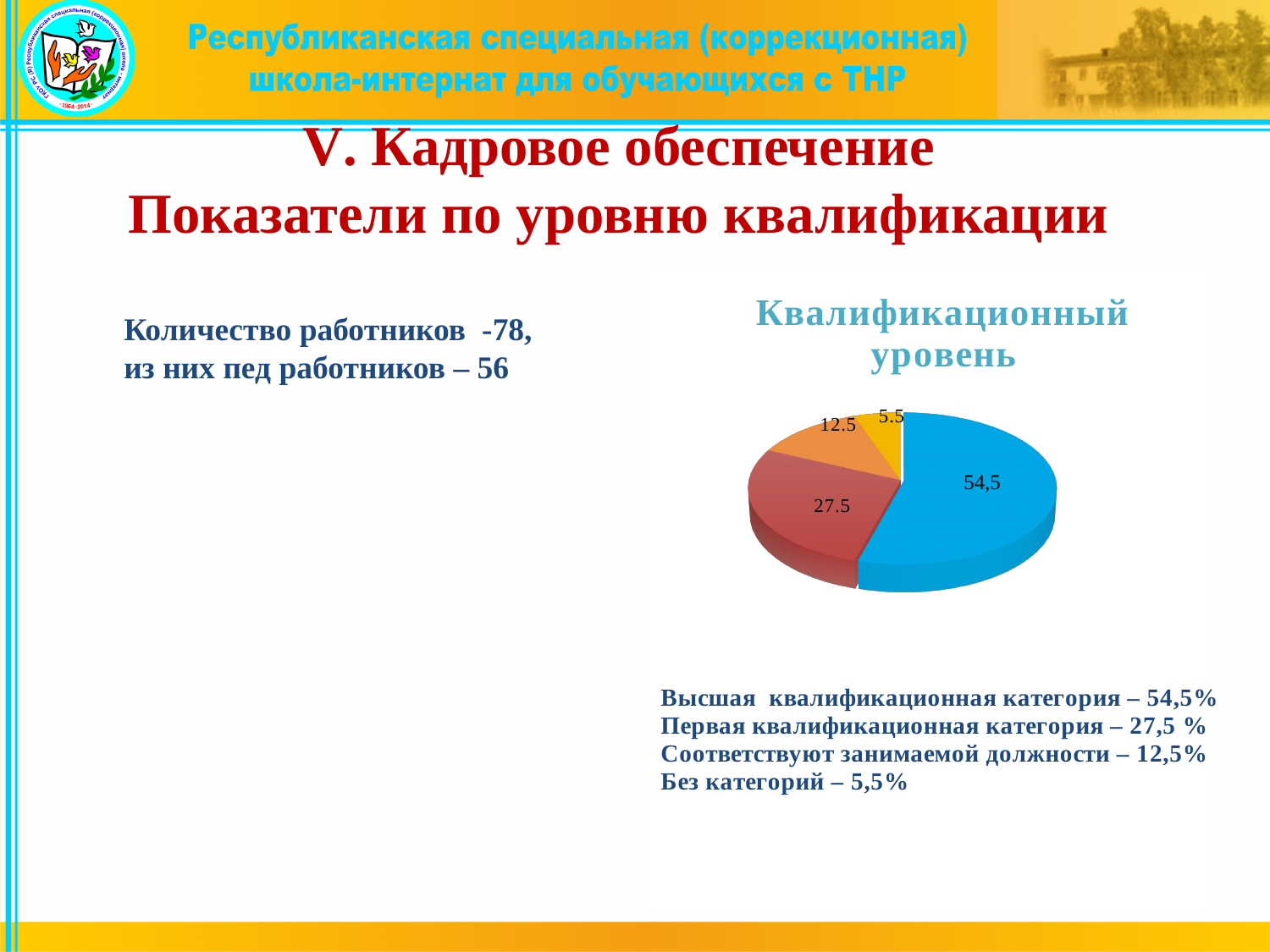
What kind of chart is shown under the title "Квалификационный уровень"? pie chart According to the slide, what share corresponds to "Без категорий"? 5,5% What value is labelled on the smallest (yellow) slice of the pie chart? 5.5 What is the difference between the 54,5 slice and the 27.5 slice in the pie chart? 27 Which slice of the pie chart is the largest? 54,5 (Высшая квалификационная категория) What is the title of the chart on the slide? Квалификационный уровень According to the slide, what share corresponds to "Высшая квалификационная категория"? 54,5% What value is labelled on the orange slice of the pie chart? 12.5 Which slice of the pie chart is the smallest? 5.5 (Без категорий) What value is labelled on the red slice of the pie chart? 27.5 What value is labelled on the largest (blue) slice of the pie chart? 54,5 How many slices does the pie chart have? 4